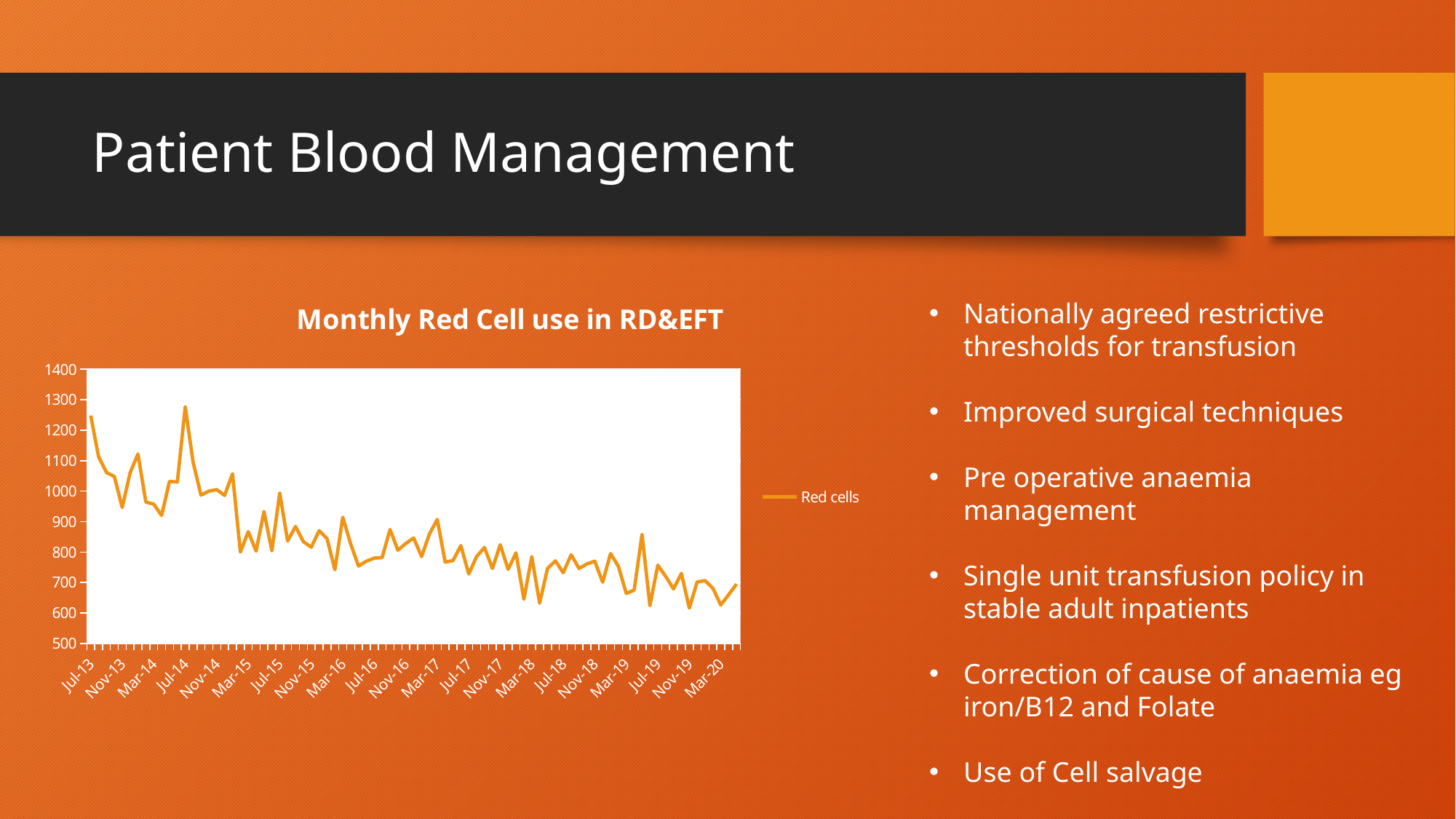
Overall, do the values rise or fall from Jul-13 to Mar-20? fall What is the name of the series shown in the legend? Red cells Which is larger, the value for Jul-13 or the value for Mar-20? Jul-13 Is the lowest point on the line greater or less than 700? less How many month labels are shown on the x axis? 21 What is the title of the chart? Monthly Red Cell use in RD&EFT What kind of chart is shown on the slide? line chart How many series does the chart legend list? 1 Is the highest point on the line greater or less than 1200? greater Is the value for Jul-13 greater or less than 1100? greater